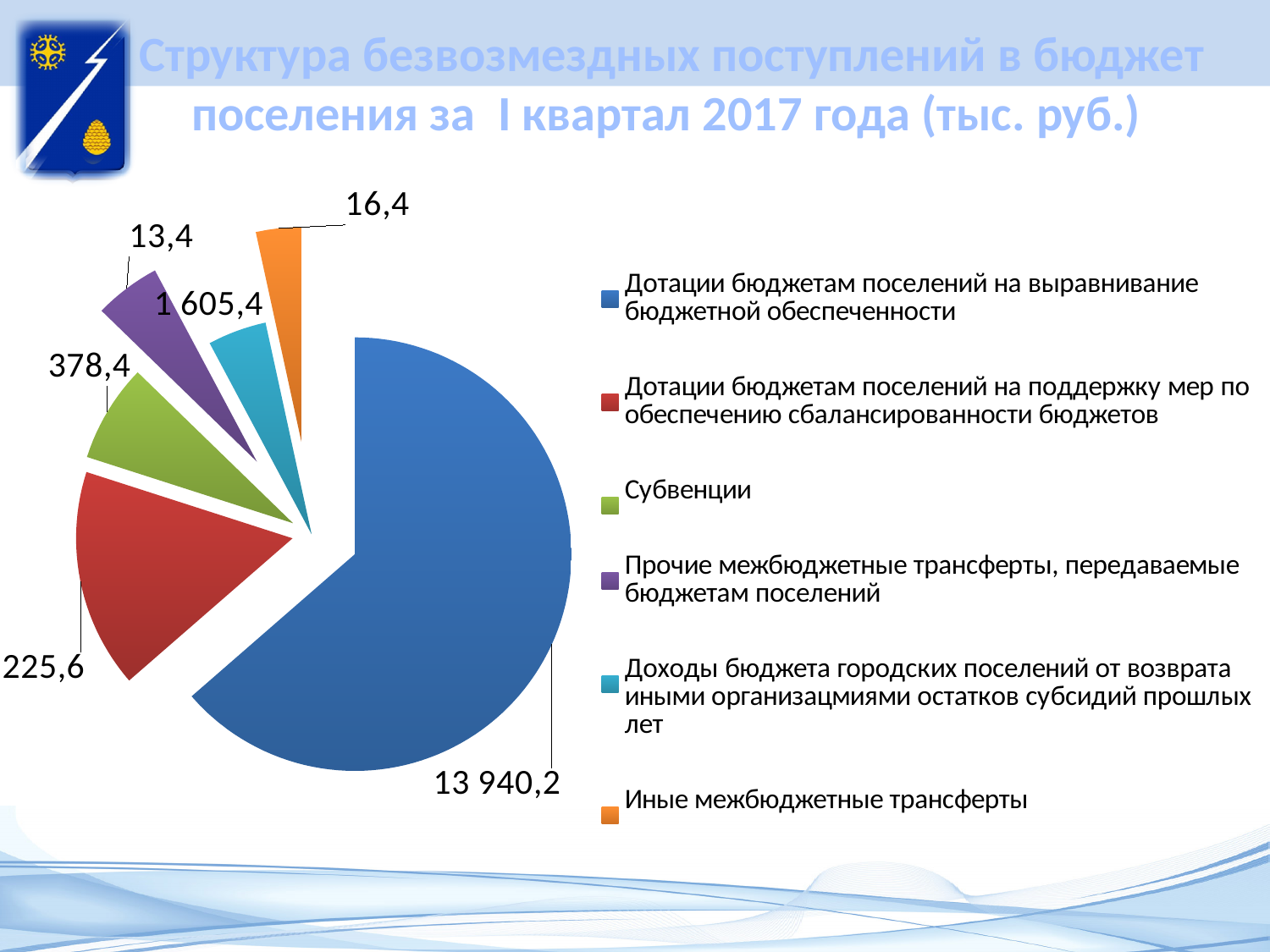
What is the difference between the value for Субвенции (378,4) and the value for Дотации бюджетам поселений на поддержку мер по обеспечению сбалансированности бюджетов (225,6)? 152,8 What is the value for Дотации бюджетам поселений на выравнивание бюджетной обеспеченности? 13 940,2 How many slices does the pie chart have? 6 Which is larger: the value for Субвенции or the value for Дотации бюджетам поселений на поддержку мер по обеспечению сбалансированности бюджетов? Субвенции What is the value for Иные межбюджетные трансферты? 16,4 What is the value for Субвенции? 378,4 What is the title of the chart on the slide? Структура безвозмездных поступлений в бюджет поселения за I квартал 2017 года (тыс. руб.) What kind of chart is shown on the slide? pie chart How many entries does the legend list? 6 Which category has the smallest value in the pie chart? Прочие межбюджетные трансферты, передаваемые бюджетам поселений What is the value for Прочие межбюджетные трансферты, передаваемые бюджетам поселений? 13,4 Which category has the largest slice of the pie? Дотации бюджетам поселений на выравнивание бюджетной обеспеченности